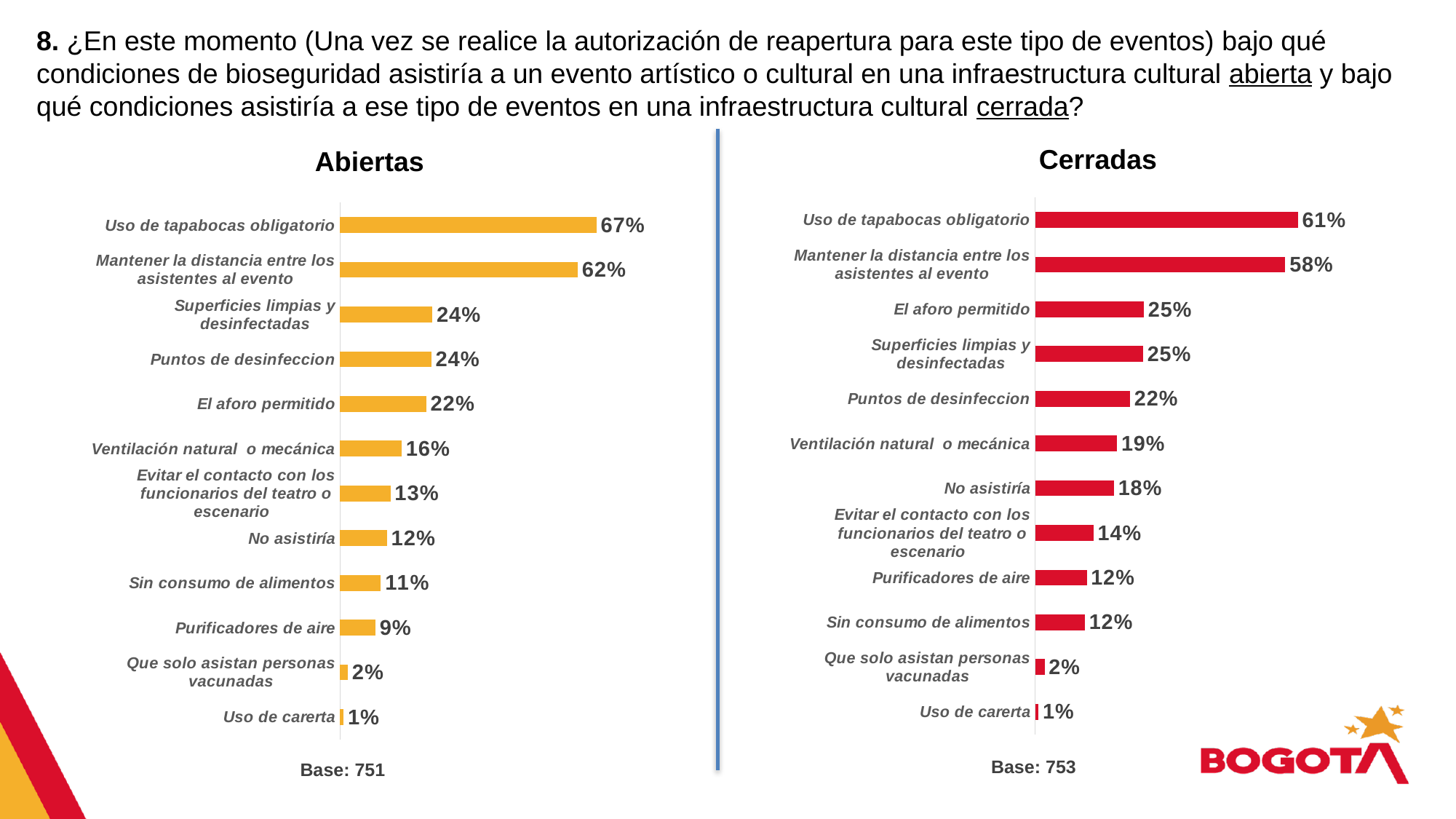
How many categories are shown in the 'Cerradas' chart? 12 What type of chart is the 'Cerradas' chart? Bar chart In the 'Abiertas' chart, what is the difference between 'Uso de tapabocas obligatorio' and 'Mantener la distancia entre los asistentes al evento'? 5% In the 'Cerradas' chart, which is larger: 'No asistiría' or 'Purificadores de aire'? No asistiría In the 'Abiertas' chart, which category has the highest value? Uso de tapabocas obligatorio In the 'Abiertas' chart, what is the value for 'Uso de tapabocas obligatorio'? 67% In the 'Cerradas' chart, what is the value for 'Mantener la distancia entre los asistentes al evento'? 58% How many categories are shown in the 'Abiertas' chart? 12 In the 'Cerradas' chart, what is the difference between 'Uso de tapabocas obligatorio' and 'El aforo permitido'? 36% In the 'Cerradas' chart, which category has the lowest value? Uso de carerta In the 'Abiertas' chart, which is larger: 'Ventilación natural o mecánica' or 'No asistiría'? Ventilación natural o mecánica What is the base (number of respondents) shown under the 'Abiertas' chart? 751